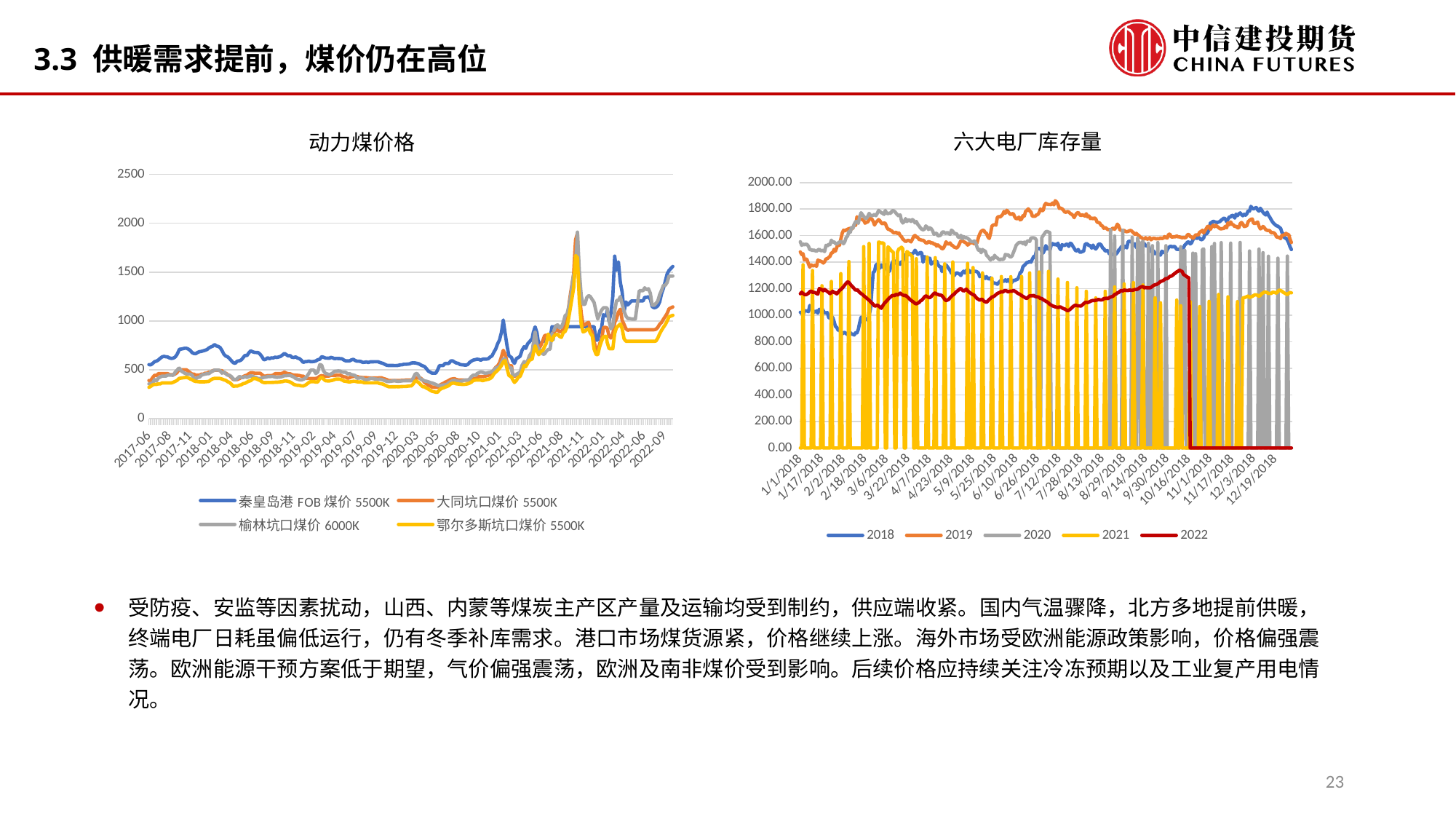
In the left chart (动力煤价格), is the value of 鄂尔多斯坑口煤价 5500K at 2022-06 greater or less than 1000? less In the left chart (动力煤价格), is the value of 秦皇岛港 FOB 煤价 5500K at 2022-09 greater or less than 1000? greater In the right chart (六大电厂库存量), is the value of the 2022 series at 1/1/2018 greater or less than 1000.00? greater What is the title of the right chart? 六大电厂库存量 In the right chart (六大电厂库存量), at 1/1/2018, which series is higher: 2018 or 2019? 2019 In the left chart (动力煤价格), which series is shown in yellow? 鄂尔多斯坑口煤价 5500K How many series does the legend of the right chart (六大电厂库存量) list? 5 How many series does the legend of the left chart (动力煤价格) list? 4 What kind of chart is the left chart titled 动力煤价格? line chart In the left chart (动力煤价格), does 秦皇岛港 FOB 煤价 5500K overall rise or fall from 2017-06 to 2022-09? rise In the left chart (动力煤价格), at 2017-06, which is higher: 秦皇岛港 FOB 煤价 5500K or 鄂尔多斯坑口煤价 5500K? 秦皇岛港 FOB 煤价 5500K